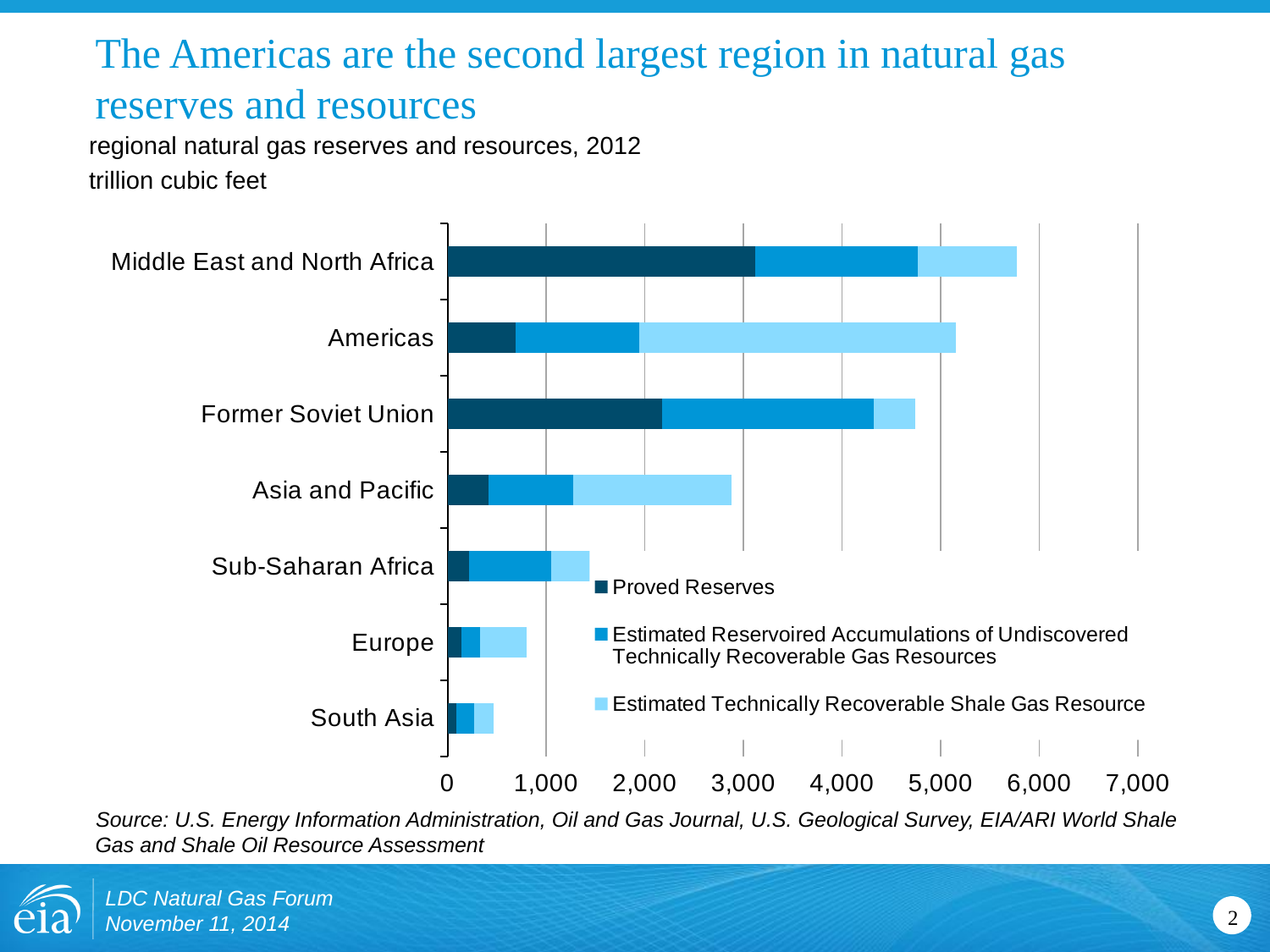
Which has a larger total bar, Former Soviet Union or Asia and Pacific? Former Soviet Union How many regions are plotted on the chart? 7 What kind of chart is shown on the slide? Stacked bar chart Which region has the largest Proved Reserves segment? Middle East and North Africa How many series does the legend list? 3 Is the total bar for Sub-Saharan Africa greater or less than 1,000 trillion cubic feet? greater Which region has the smallest total natural gas reserves and resources? South Asia Which region has the largest total natural gas reserves and resources? Middle East and North Africa Is the total bar for Middle East and North Africa greater or less than 5,000 trillion cubic feet? greater Which region has the largest Estimated Technically Recoverable Shale Gas Resource segment? Americas What unit is the chart measured in? trillion cubic feet Is the total bar for Europe greater or less than 1,000 trillion cubic feet? less